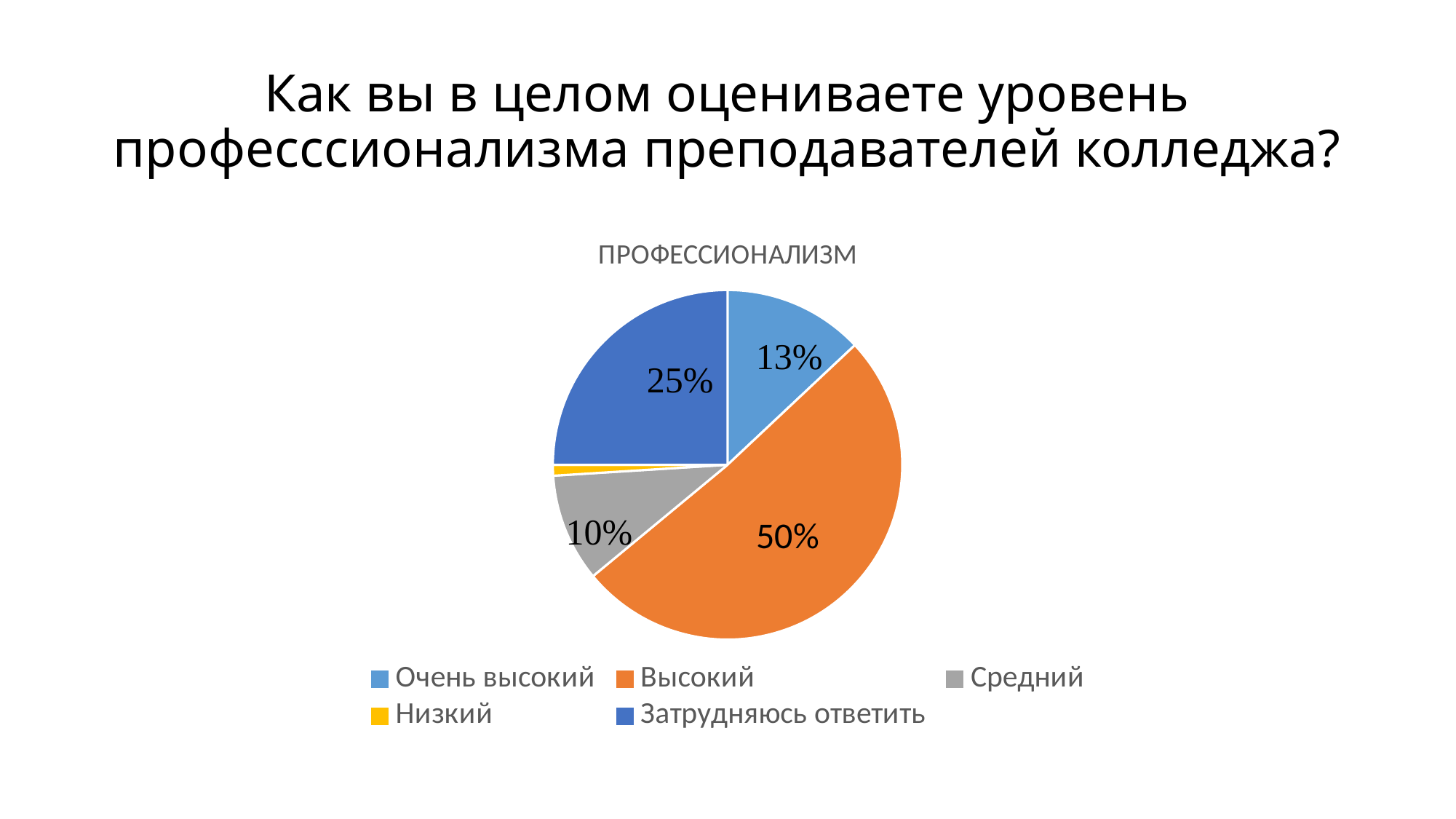
Which is larger, the "Очень высокий" slice or the "Средний" slice? Очень высокий What is the value shown for "Очень высокий"? 13% What is the difference between the "Высокий" and "Затрудняюсь ответить" shares? 25% What kind of chart is shown on the slide? Pie chart What is the value shown for "Затрудняюсь ответить"? 25% Which category has the smallest slice of the pie? Низкий Which category has the largest slice of the pie? Высокий What colour is the "Низкий" slice in the legend? Yellow What share of the pie does the "Высокий" slice represent? 50% How many categories does the pie chart show? 5 What is the title of the chart? ПРОФЕССИОНАЛИЗМ What is the value shown for "Средний"? 10%